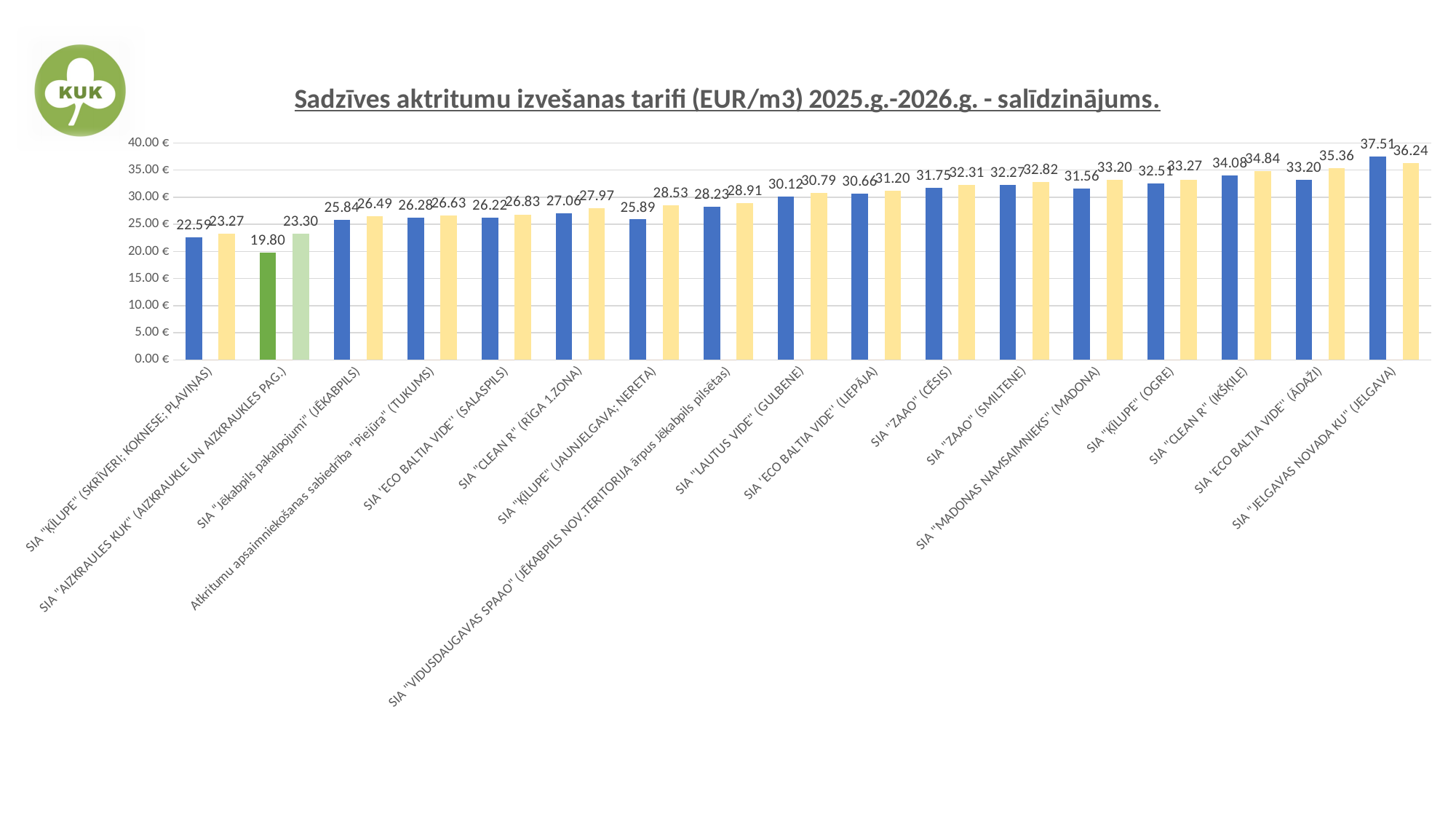
What is the value of the blue (first) bar for SIA "JELGAVAS NOVADA KU" (JELGAVA)? 37.51 What is the value of the second (light green) bar for SIA "AIZKRAUKLES KUK" (AIZKRAUKLE UN AIZKRAUKLES PAG.)? 23.30 What is the value of the green (first) bar for SIA "AIZKRAUKLES KUK" (AIZKRAUKLE UN AIZKRAUKLES PAG.)? 19.80 What type of chart is shown on the slide? bar chart Is the value of the blue (first) bar for SIA "LAUTUS VIDE" (GULBENE) greater or less than 30.00 €? greater How many companies (categories) are shown on the x axis of the chart? 17 Which category has the lowest bar in the chart? SIA "AIZKRAUKLES KUK" (AIZKRAUKLE UN AIZKRAUKLES PAG.) What is the difference between the yellow (second) bar and the blue (first) bar for SIA "ĶILUPE" (JAUNJELGAVA; NERETA)? 2.64 For SIA "JELGAVAS NOVADA KU" (JELGAVA), which bar is larger, the blue (first) bar or the yellow (second) bar? the blue (first) bar What is the title of the chart? Sadzīves aktritumu izvešanas tarifi (EUR/m3) 2025.g.-2026.g. - salīdzinājums. Which category has the highest bar in the chart? SIA "JELGAVAS NOVADA KU" (JELGAVA) What is the value of the yellow (second) bar for SIA "CLEAN R" (RĪGA 1.ZONA)? 27.97